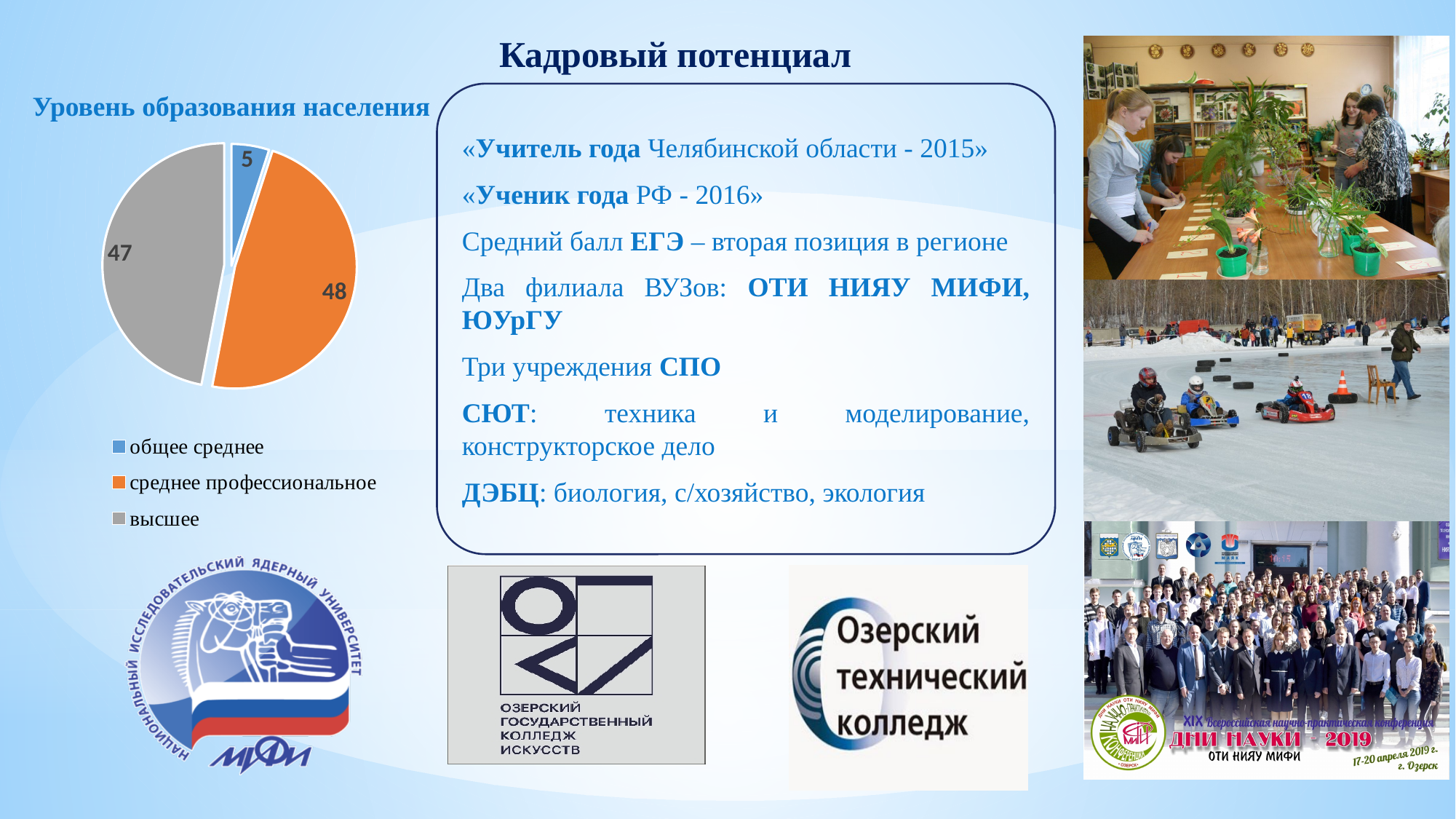
What is the value for «среднее профессиональное» in the pie chart? 48 Which category has the largest slice in the pie chart? среднее профессиональное What is the difference between the values for «среднее профессиональное» and «высшее» in the pie chart? 1 What is the title of the pie chart? Уровень образования населения What colour is the «среднее профессиональное» slice in the pie chart? orange What kind of chart is shown under the heading «Уровень образования населения»? pie chart Which category has the smallest slice in the pie chart? общее среднее What is the difference between the values for «высшее» and «общее среднее» in the pie chart? 42 What is the value for «высшее» in the pie chart? 47 Which is larger in the pie chart: «высшее» or «общее среднее»? высшее What is the value for «общее среднее» in the pie chart? 5 How many categories does the pie chart show? 3